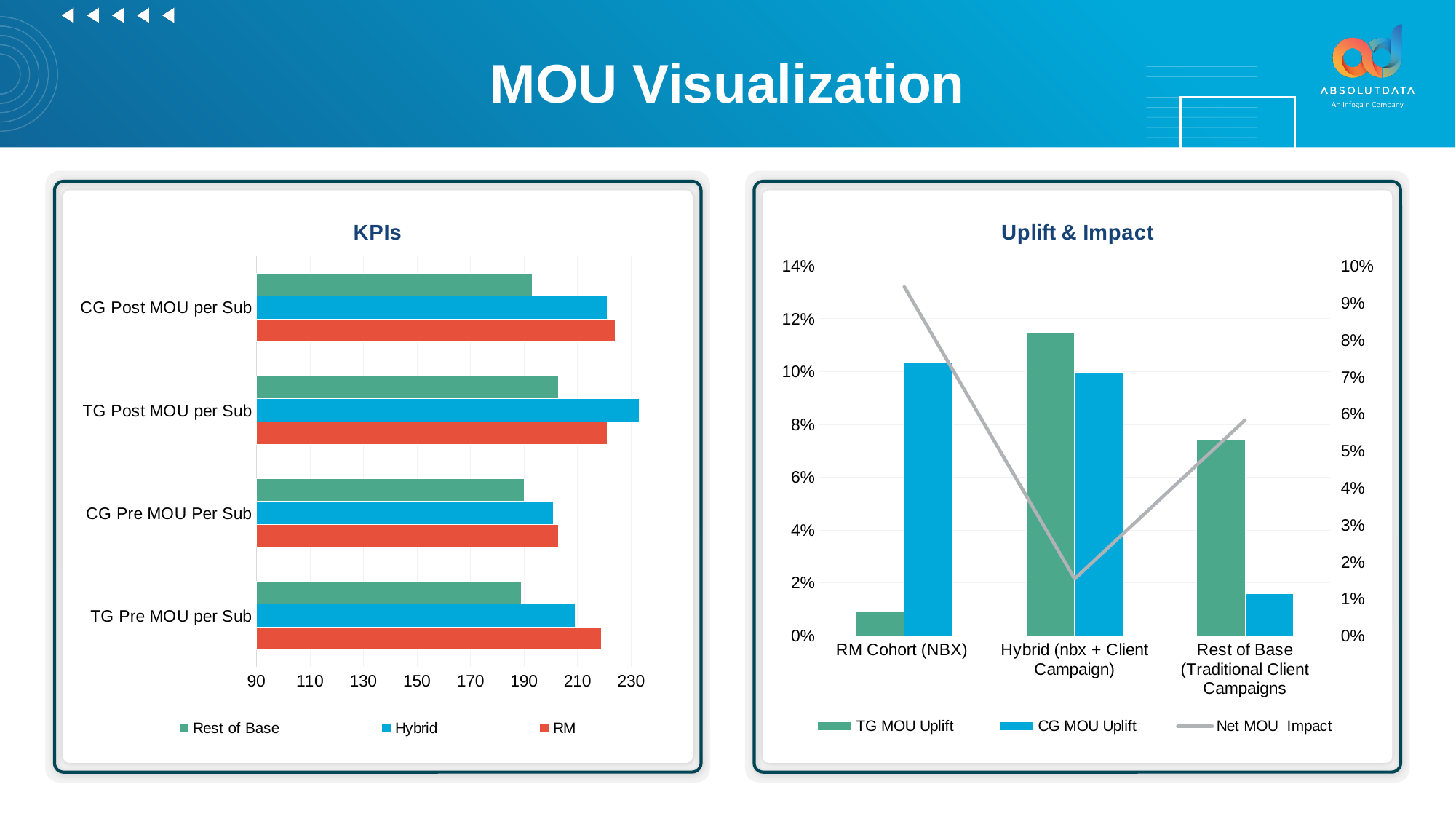
What type of chart is the KPIs chart? bar chart How many categories are shown on the Uplift & Impact chart? 3 In the Uplift & Impact chart, which category has the lowest Net MOU Impact? Hybrid (nbx + Client Campaign) In the KPIs chart, is the Hybrid value for TG Post MOU per Sub greater or less than 210? greater In the KPIs chart, which is larger for TG Post MOU per Sub: Hybrid or RM? Hybrid How many series does the legend of the Uplift & Impact chart list? 3 In the KPIs chart, is the RM value for TG Pre MOU per Sub greater or less than 210? greater In the KPIs chart, which series has the lowest value for TG Post MOU per Sub? Rest of Base In the Uplift & Impact chart, is the TG MOU Uplift for Hybrid (nbx + Client Campaign) greater or less than 10%? greater How many categories are shown on the KPIs chart? 4 How many series does the legend of the KPIs chart list? 3 In the Uplift & Impact chart, which category has the highest TG MOU Uplift? Hybrid (nbx + Client Campaign)